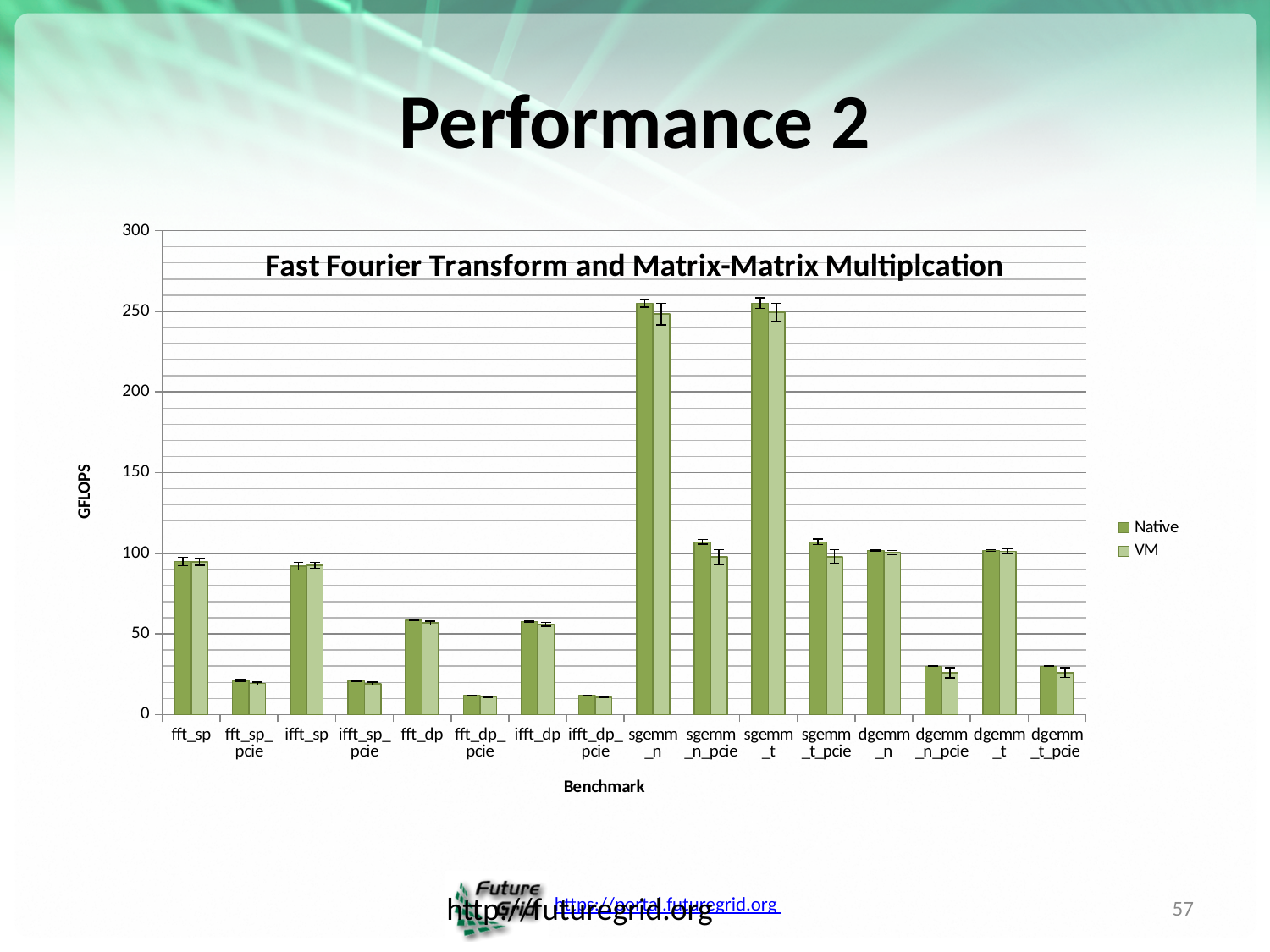
Which has the larger VM value, dgemm_n or dgemm_n_pcie? dgemm_n Is the Native value for fft_dp greater or less than 50? greater What is the label of the y axis? GFLOPS Which has the larger Native value, fft_dp or fft_dp_pcie? fft_dp What kind of chart is shown on the slide? bar chart How many series does the legend list? 2 Is the Native value for fft_sp greater or less than 100? less What are the two series named in the legend? Native and VM Is the VM value for dgemm_n_pcie greater or less than 50? less How many benchmark categories are shown on the x axis? 16 Which has the larger Native value, sgemm_n or fft_sp? sgemm_n